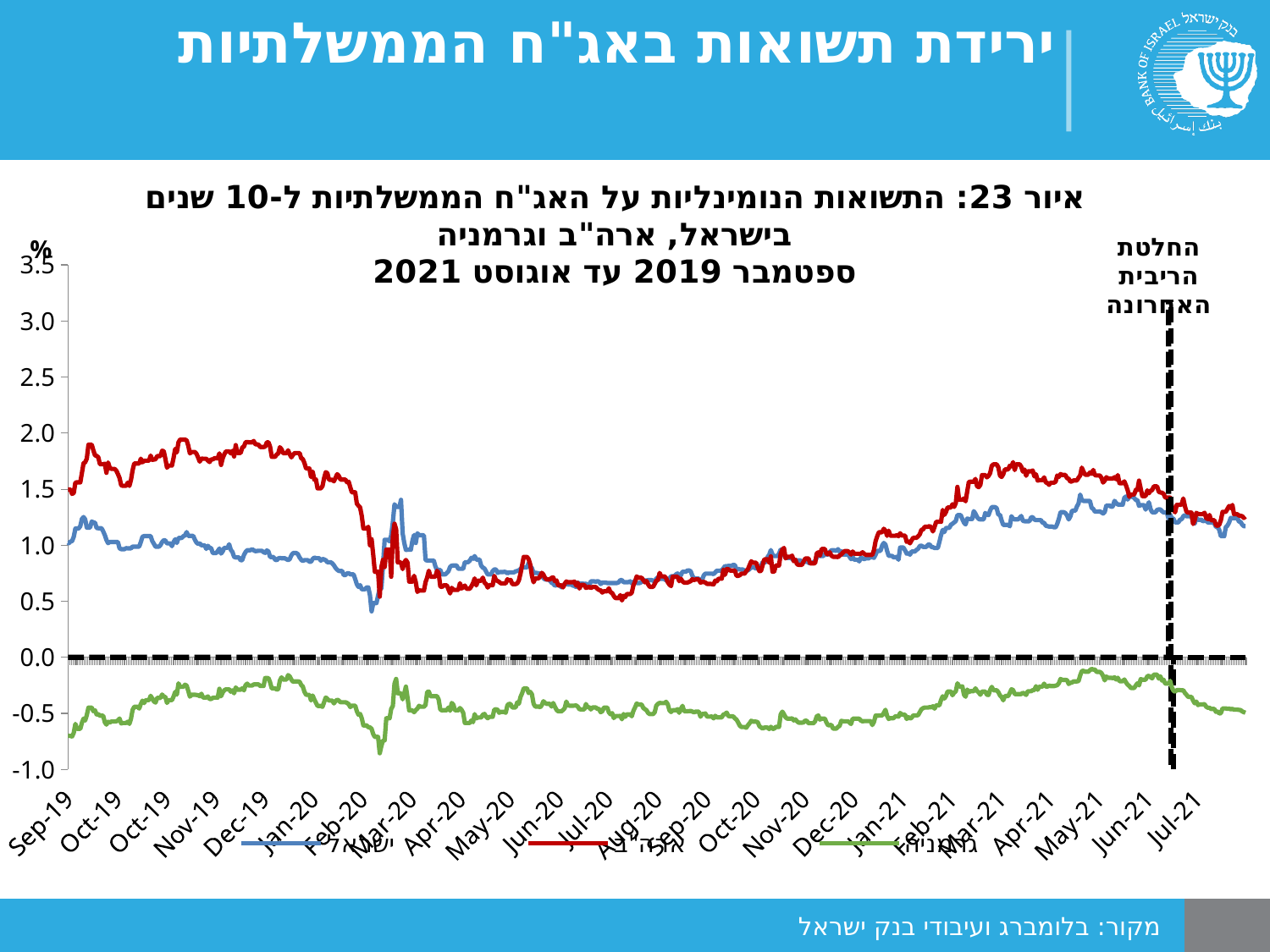
In Dec-19, which line is higher, the red line or the blue line? red line Is the value of the green line in Sep-19 greater or less than 0.0? less Is the value of the red line in Mar-21 greater or less than 1.5? greater Is the value of the red line in Jul-20 greater or less than 1.0? less What kind of chart is shown on the slide? line chart In Sep-19, which line is higher, the blue line or the green line? blue line Does the red line rise or fall between Dec-19 and Jul-20? fall How many series does the legend list? 3 What is the highest value printed on the vertical axis? 3.5 What unit is shown at the top of the vertical axis? %